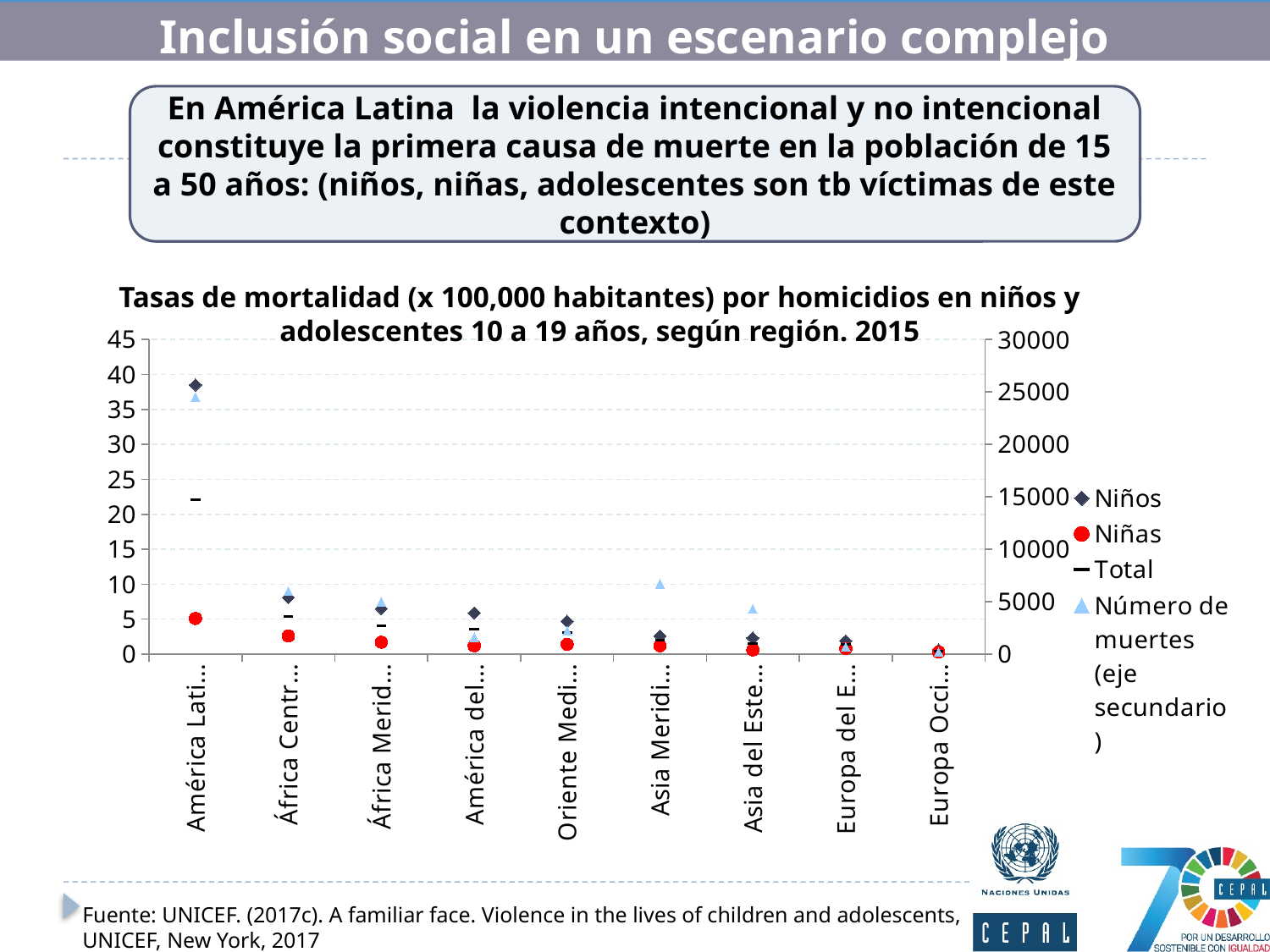
Is the Niños value for the first region (América Lati...) greater or less than 35? greater What kind of chart is shown on the slide? scatter chart For the first region (América Lati...), which is larger, the Niños value or the Niñas value? Niños Is the Número de muertes value for the first region (América Lati...) greater or less than 20000 on the secondary axis? greater Is the Total value for the first region (América Lati...) greater or less than 15? greater Which region has the highest value for the Niños series? América Lati... (the first category) Do the Niños values generally rise or fall moving from left to right along the x axis? fall Which region has the lowest value for the Niños series? Europa Occi... (the last category) How many series does the chart legend list? 4 How many regions (categories) are plotted along the x axis? 9 Which legend series is plotted on the secondary axis? Número de muertes